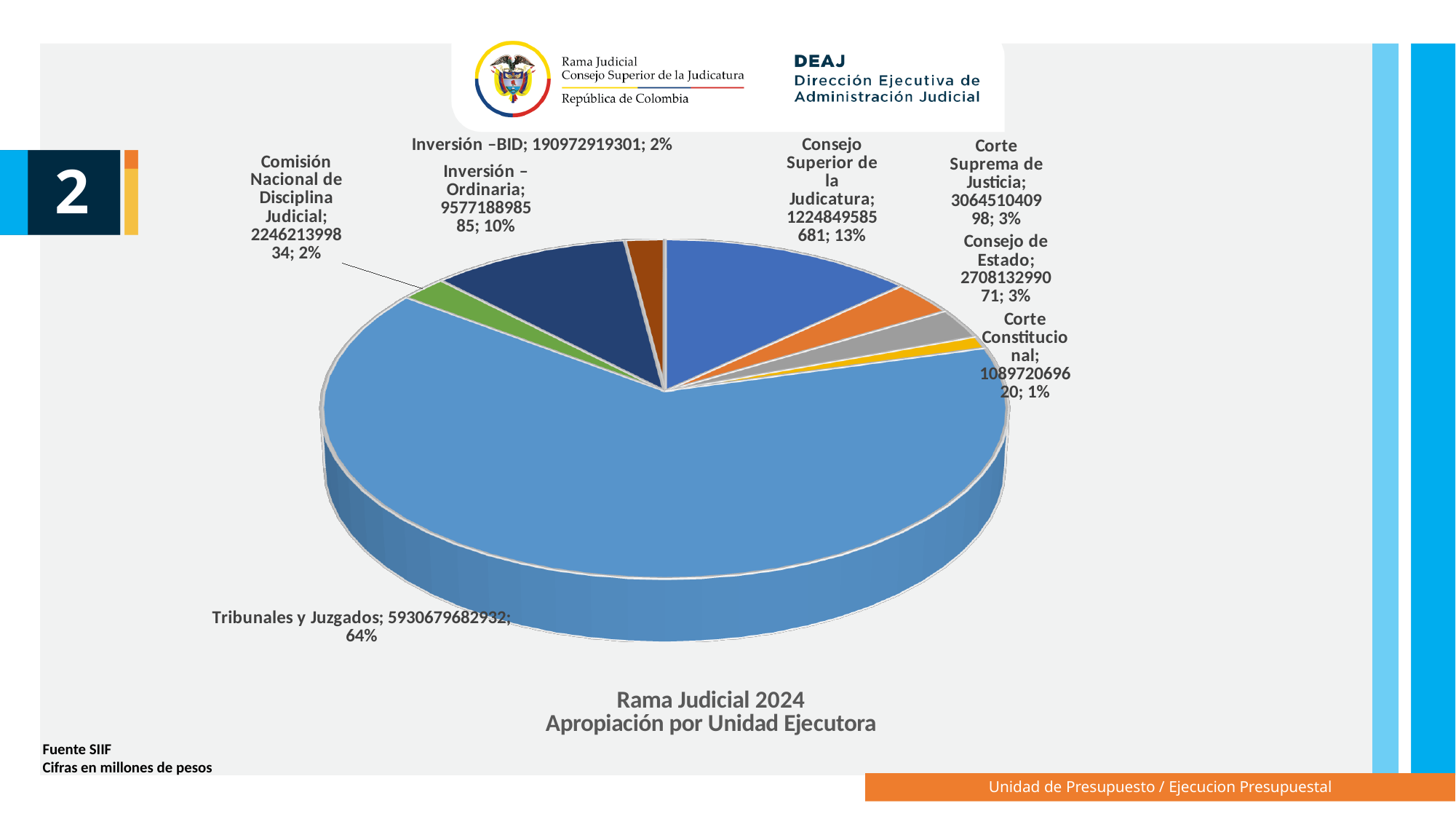
What is the difference between the value for Tribunales y Juzgados and the value for Consejo Superior de la Judicatura? 4705830097251 Which unit has the smallest share of the pie? Corte Constitucional What is the value shown for Tribunales y Juzgados? 5930679682932 Which unit has the largest share of the pie? Tribunales y Juzgados How many slices does the pie chart have? 8 What is the title of the chart? Rama Judicial 2024 Apropiación por Unidad Ejecutora What is the value shown for Corte Constitucional? 108972069620 What is the value shown for Inversión – Ordinaria? 957718898585 Which is larger, the value for Consejo Superior de la Judicatura or the value for Inversión – Ordinaria? Consejo Superior de la Judicatura What percentage share does Tribunales y Juzgados have? 64% What is the value shown for Consejo Superior de la Judicatura? 1224849585681 What kind of chart is shown on the slide? Pie chart